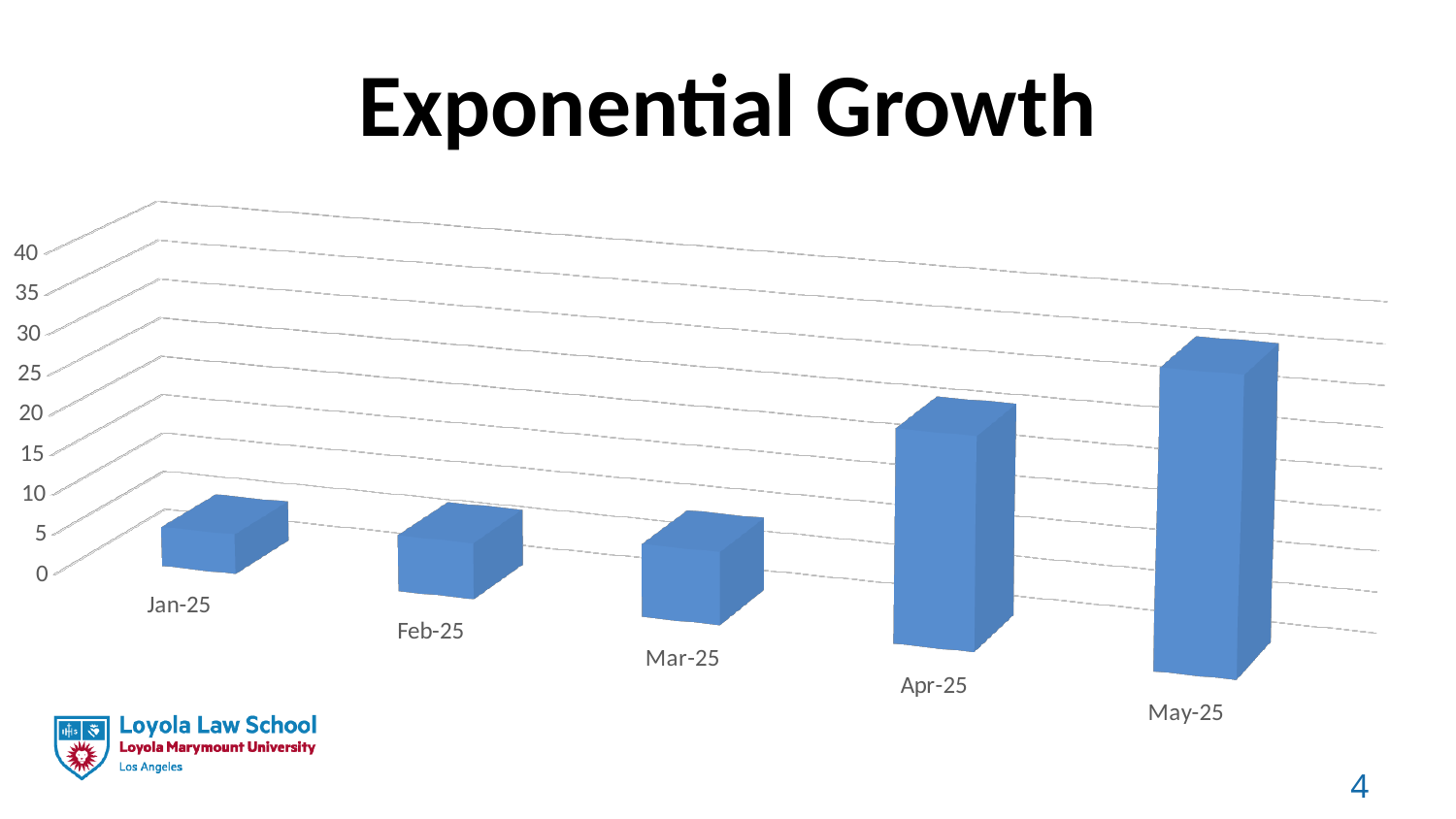
Which category has the highest value in the chart? May-25 Is the value for May-25 greater or less than 20? greater What is the title of the chart? Exponential Growth Which is larger, the value for Apr-25 or the value for Mar-25? Apr-25 What type of chart is shown on the slide? bar chart How many categories are shown on the x axis of the chart? 5 Do the values generally rise or fall from Jan-25 to May-25? rise What is the first category shown on the x axis? Jan-25 Is the value for Jan-25 greater or less than 10? less Is the value for Apr-25 greater or less than 10? greater Which is larger, the value for May-25 or the value for Jan-25? May-25